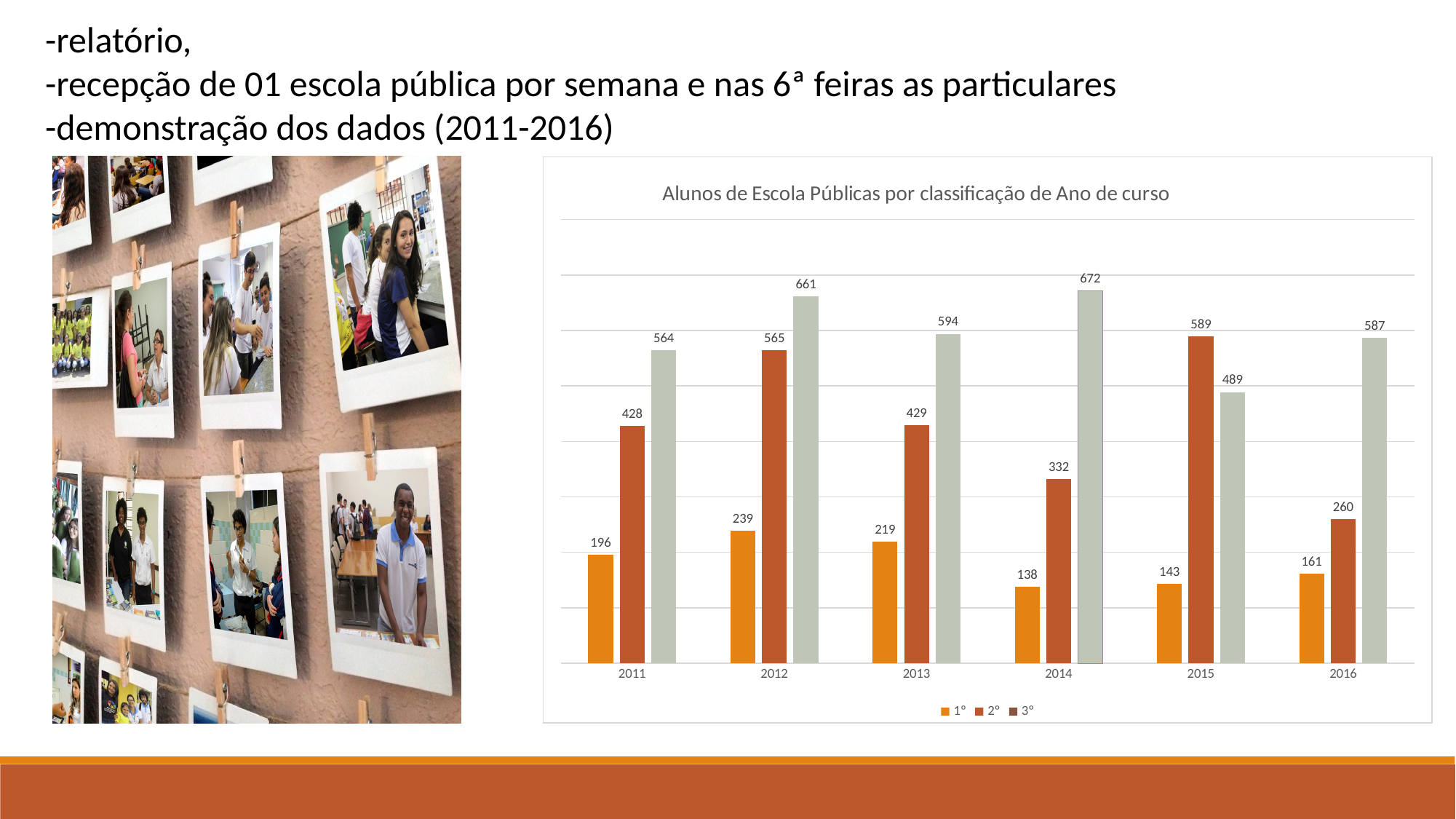
Does the 2° series rise or fall from 2015 to 2016? fall What is the value for 1° in 2011? 196 What kind of chart is shown? bar chart Which is larger in 2015, the 2° value or the 3° value? 2° What is the difference between the 2° and 1° values in 2012? 326 What is the value for 3° in 2014? 672 How many years are shown on the x axis? 6 What is the value for 2° in 2015? 589 In which year is the 3° series highest? 2014 What is the title of the chart? Alunos de Escola Públicas por classificação de Ano de curso In which year is the 1° series lowest? 2014 How many series does the legend list? 3